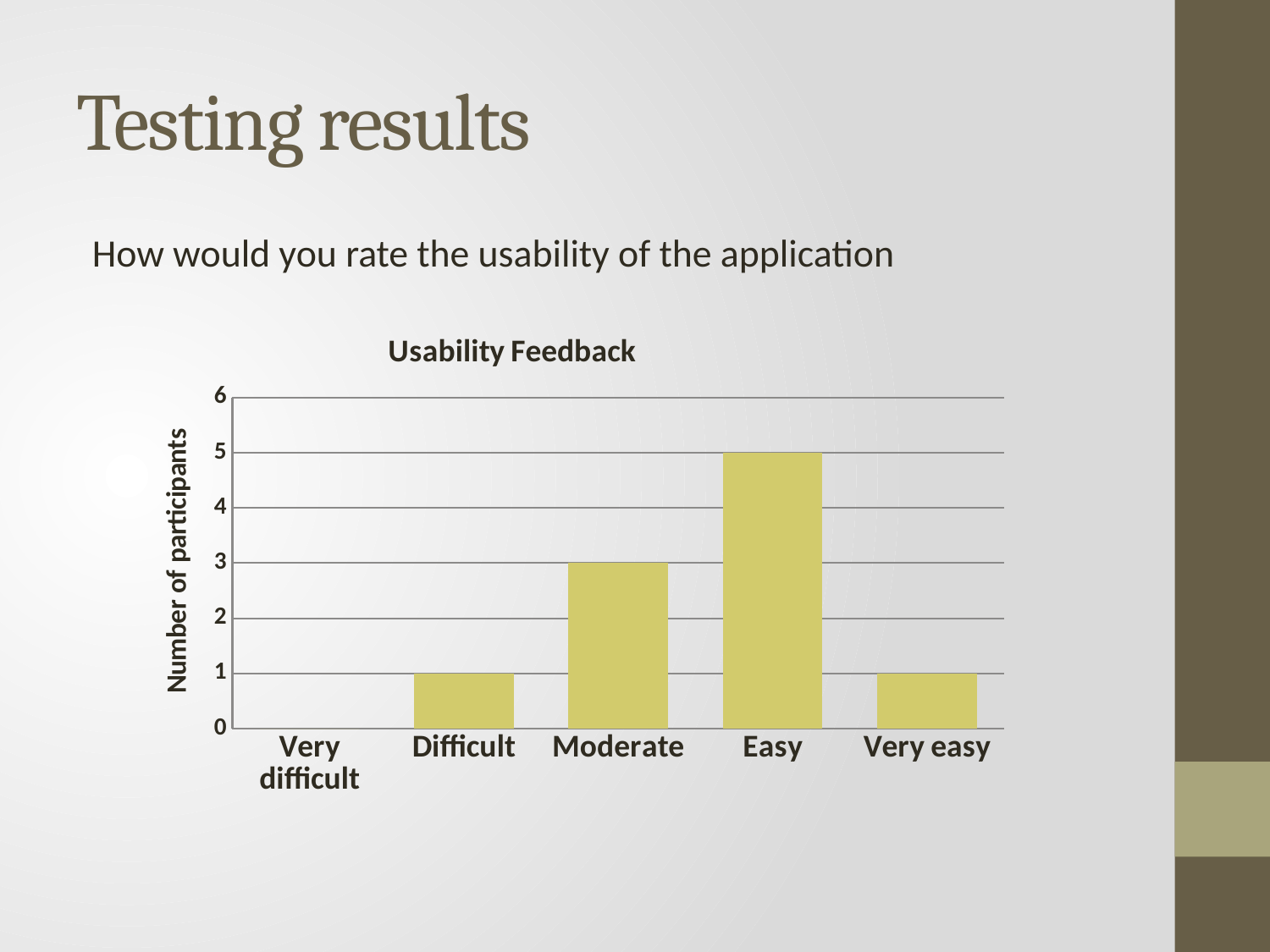
What is the difference in number of participants between Easy and Moderate? 2 What is the number of participants for Very easy? 1 Which category has the highest number of participants? Easy What is the number of participants for Difficult? 1 What is the label of the y axis? Number of participants Which has more participants, Moderate or Very easy? Moderate Which category has the lowest number of participants? Very difficult What is the number of participants for Moderate? 3 What is the number of participants for Easy? 5 What kind of chart is shown on the slide? bar chart How many categories are shown on the x axis of the chart? 5 What is the title of the chart? Usability Feedback